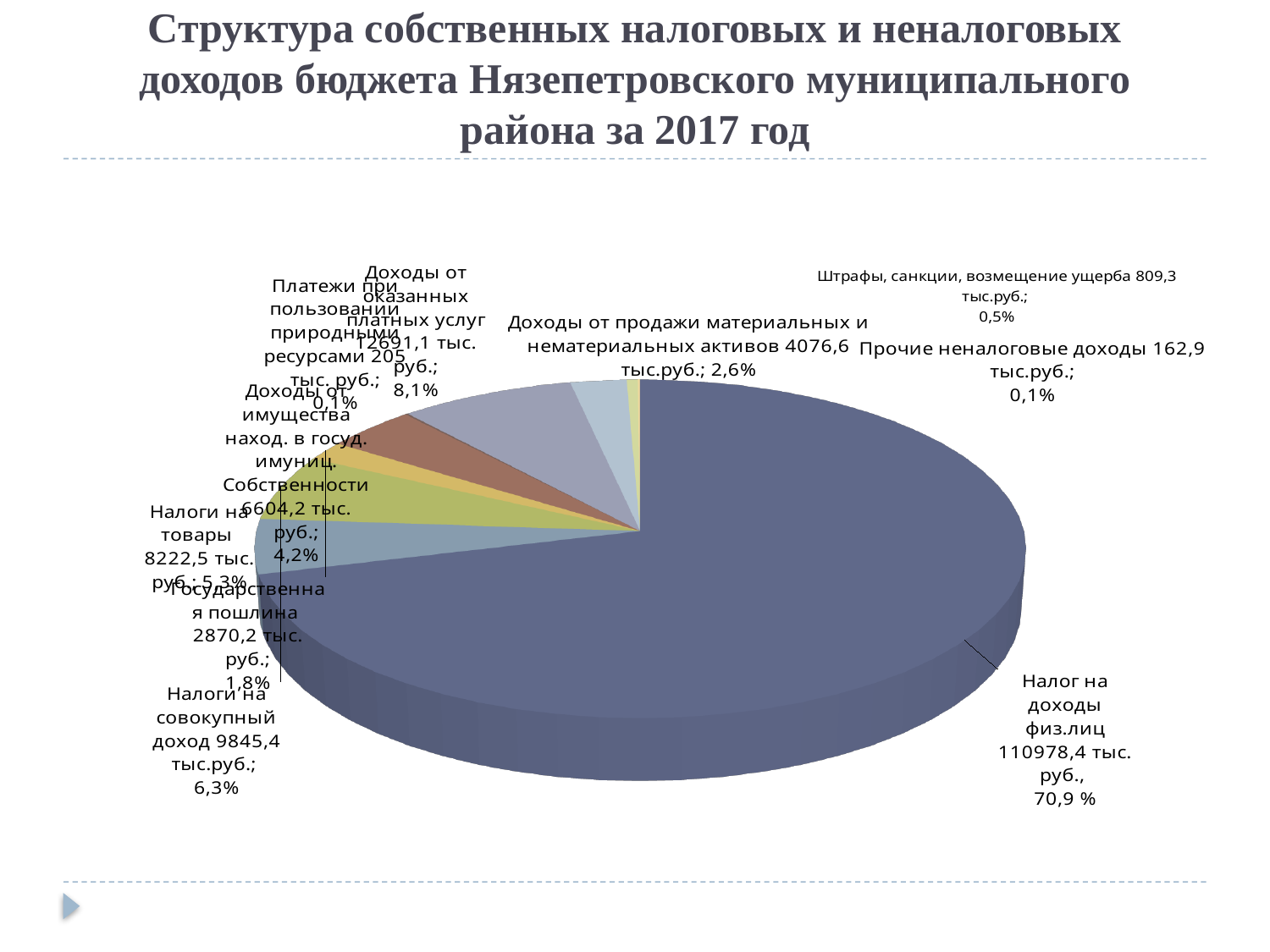
What kind of chart is shown on the slide? pie chart Which year does the chart title say the data is for? 2017 What is the difference in percentage points between Доходы от оказанных платных услуг (8,1%) and Налоги на совокупный доход (6,3%)? 1,8% What share of the pie does Налог на доходы физ.лиц account for? 70,9 % What percentage is shown for Налоги на совокупный доход? 6,3% Which category has the largest share of the pie? Налог на доходы физ.лиц Which category has the smallest value in the chart? Прочие неналоговые доходы What is the value shown for Доходы от оказанных платных услуг? 12691,1 тыс. руб. What is the value shown for Штрафы, санкции, возмещение ущерба? 809,3 тыс.руб. What percentage is shown for Доходы от продажи материальных и нематериальных активов? 2,6% Which is larger: Налоги на товары or Государственная пошлина? Налоги на товары How many categories (slices) does the pie chart show? 10